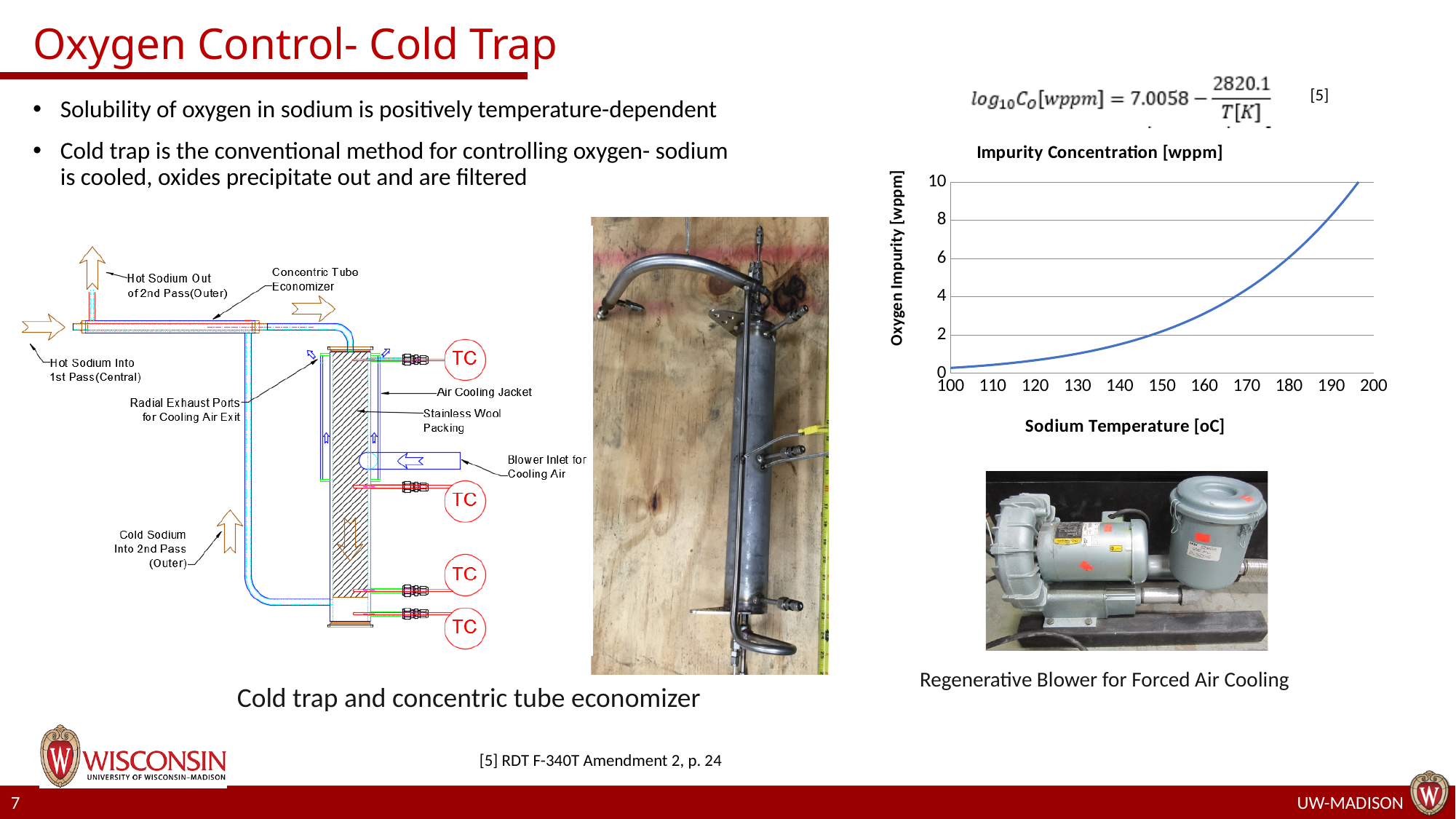
How many lines are plotted in the Impurity Concentration chart? 1 In the Impurity Concentration chart, is the oxygen impurity at 160 oC greater or less than 2 wppm? greater In the Impurity Concentration chart, is the oxygen impurity at 120 oC greater or less than 2 wppm? less What is the y-axis label of the Impurity Concentration chart? Oxygen Impurity [wppm] In the Impurity Concentration chart, does oxygen impurity rise or fall as sodium temperature increases? rise In the Impurity Concentration chart, which has the higher oxygen impurity: 130 oC or 180 oC? 180 oC What kind of chart is the Impurity Concentration [wppm] chart? line chart In the Impurity Concentration chart, is the oxygen impurity at 140 oC greater or less than 2 wppm? less What is the x-axis label of the Impurity Concentration chart? Sodium Temperature [oC]